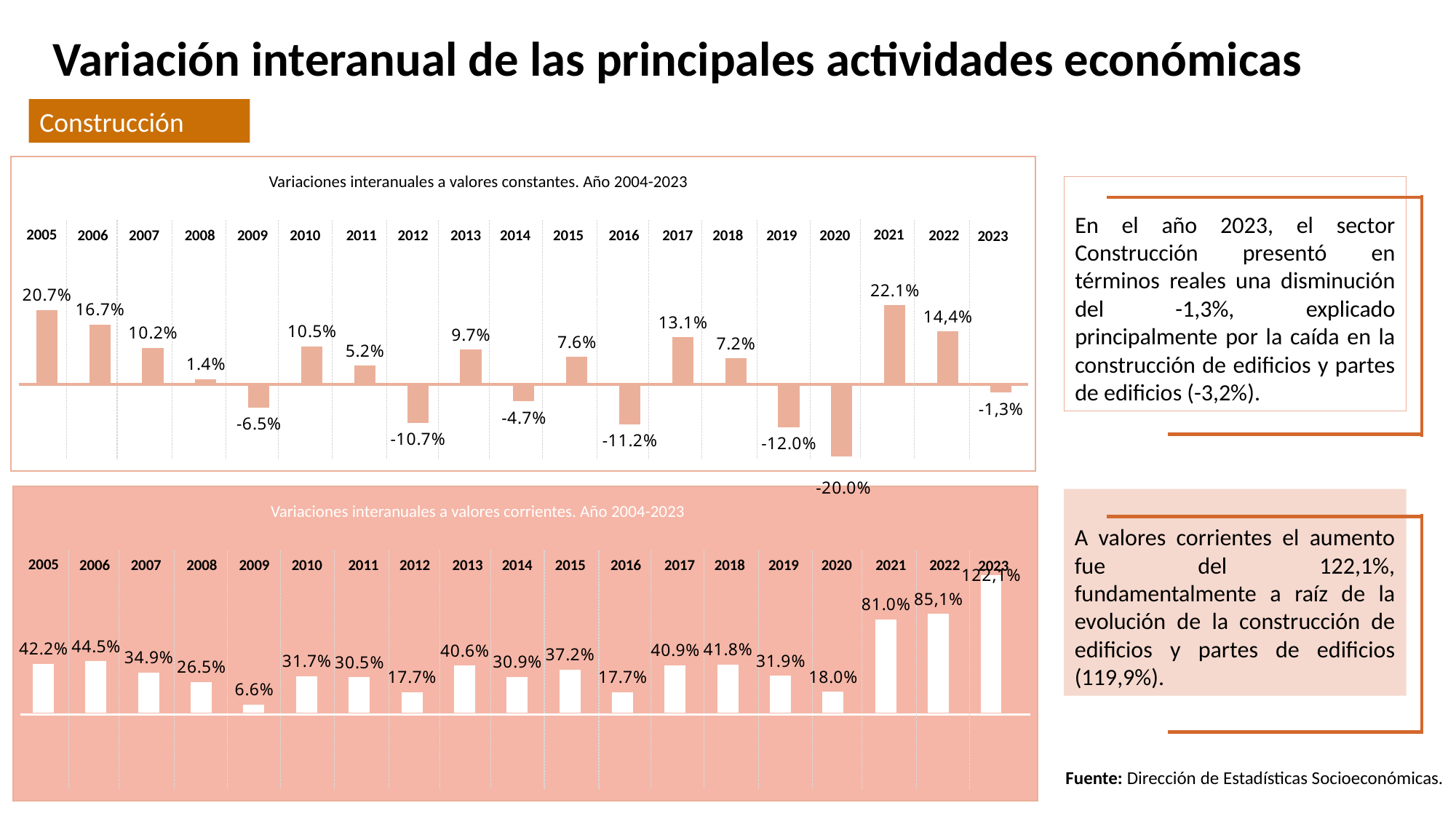
In the chart 'Variaciones interanuales a valores constantes', how many years are plotted? 19 In the chart 'Variaciones interanuales a valores corrientes', which year has the lowest value? 2009 In the chart 'Variaciones interanuales a valores constantes', what is the difference between the values for 2005 and 2006? 4.0 percentage points What type of chart is the bottom chart 'Variaciones interanuales a valores corrientes'? Bar chart In the chart 'Variaciones interanuales a valores constantes', which year has the highest value? 2021 In the chart 'Variaciones interanuales a valores corrientes', what is the value for 2009? 6.6% In the chart 'Variaciones interanuales a valores corrientes', what is the difference between the values for 2022 and 2021? 4.1 percentage points In the chart 'Variaciones interanuales a valores constantes', what is the value for 2023? -1,3% In the chart 'Variaciones interanuales a valores corrientes', which is larger, the value for 2017 or the value for 2018? 2018 In the chart 'Variaciones interanuales a valores constantes', what is the value for 2021? 22.1% In the chart 'Variaciones interanuales a valores corrientes', what is the value for 2023? 122,1% In the chart 'Variaciones interanuales a valores constantes', which year has the lowest value? 2020